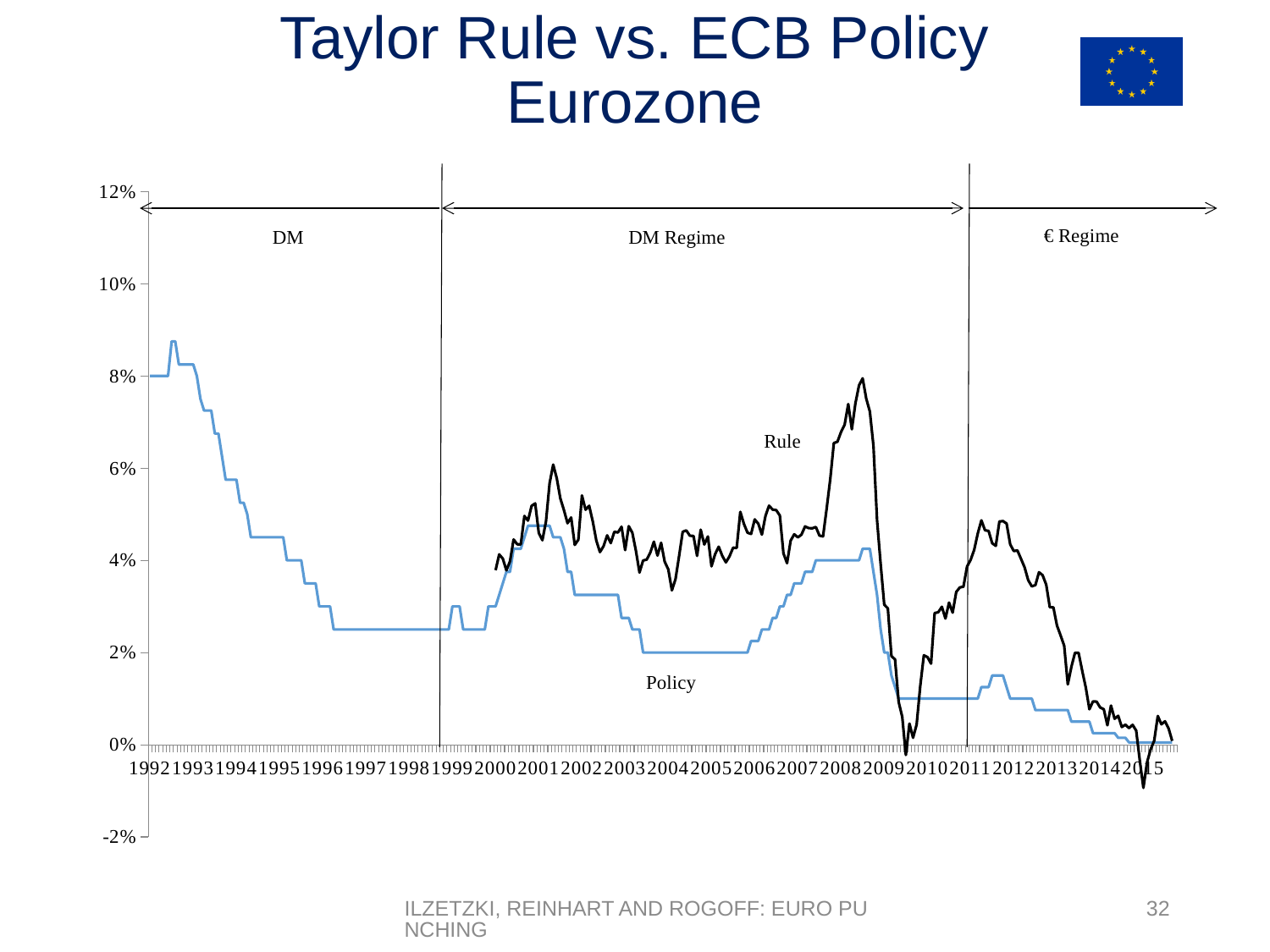
Is the Policy value in 2014 greater or less than 2%? less In 2008, which series reaches the higher value, Rule or Policy? Rule What are the three regime labels written across the top of the chart? DM, DM Regime, € Regime Is the Policy value in 1997 greater or less than 2%? greater What are the names of the two series labelled on the chart? Rule and Policy Does the Policy series rise or fall between 1992 and 1997? fall What is the first year and the last year labelled on the x axis? 1992 and 2015 How many data series are plotted on the chart? 2 What kind of chart is shown on the slide? line chart Is the peak of the Rule series in 2008 greater or less than 6%? greater In 2012, which series is higher, Rule or Policy? Rule